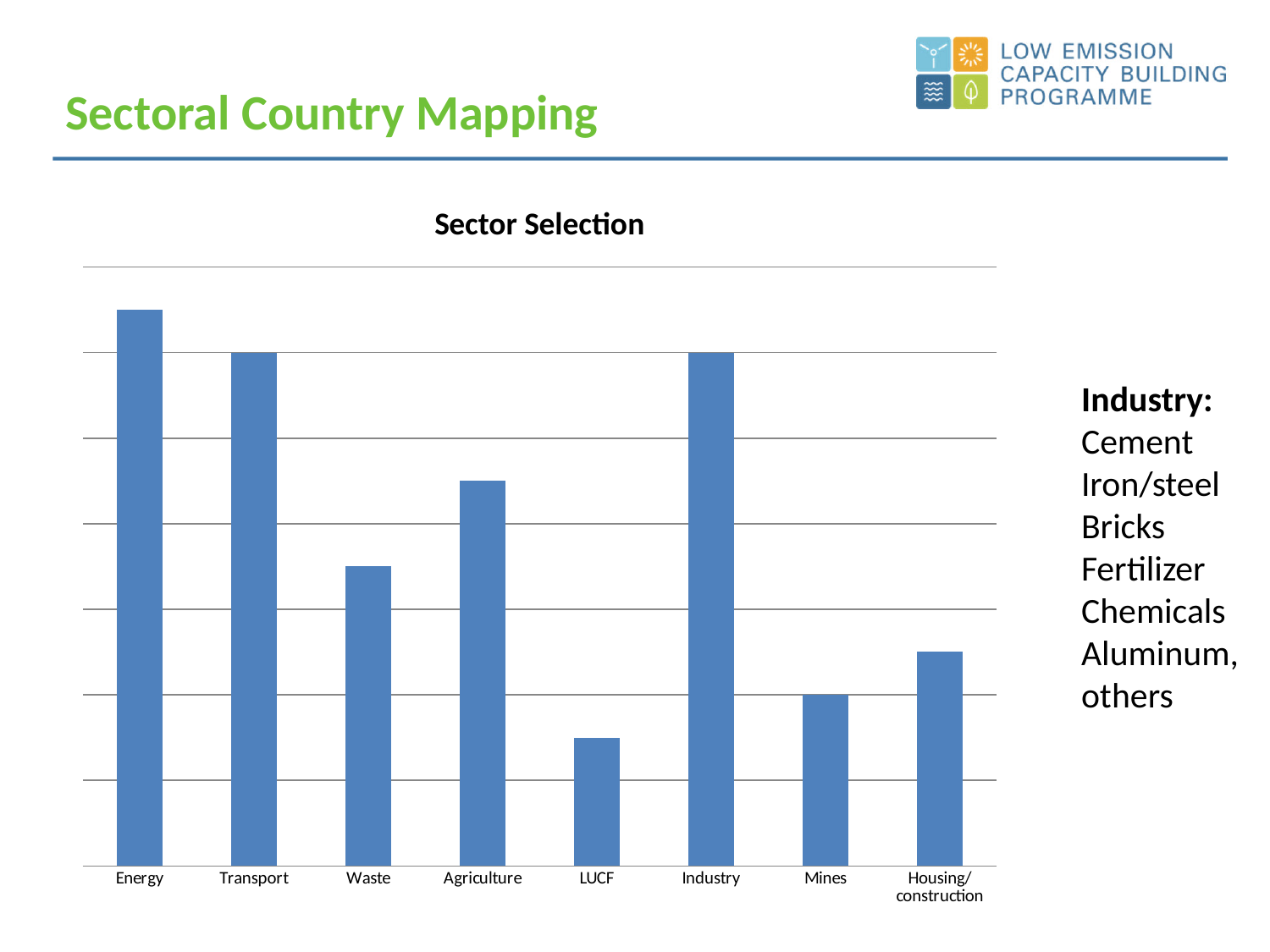
Which is larger, the value for Housing/construction or the value for Mines? Housing/construction Which is larger, the value for Energy or the value for Transport? Energy Which is larger, the value for Waste or the value for Agriculture? Agriculture What type of chart is shown on the slide? bar chart What is the label of the last category on the x axis? Housing/construction Which sector has the lowest bar? LUCF What is the title of the chart? Sector Selection How many sectors (categories) are plotted on the x axis? 8 Which sector has the highest bar? Energy